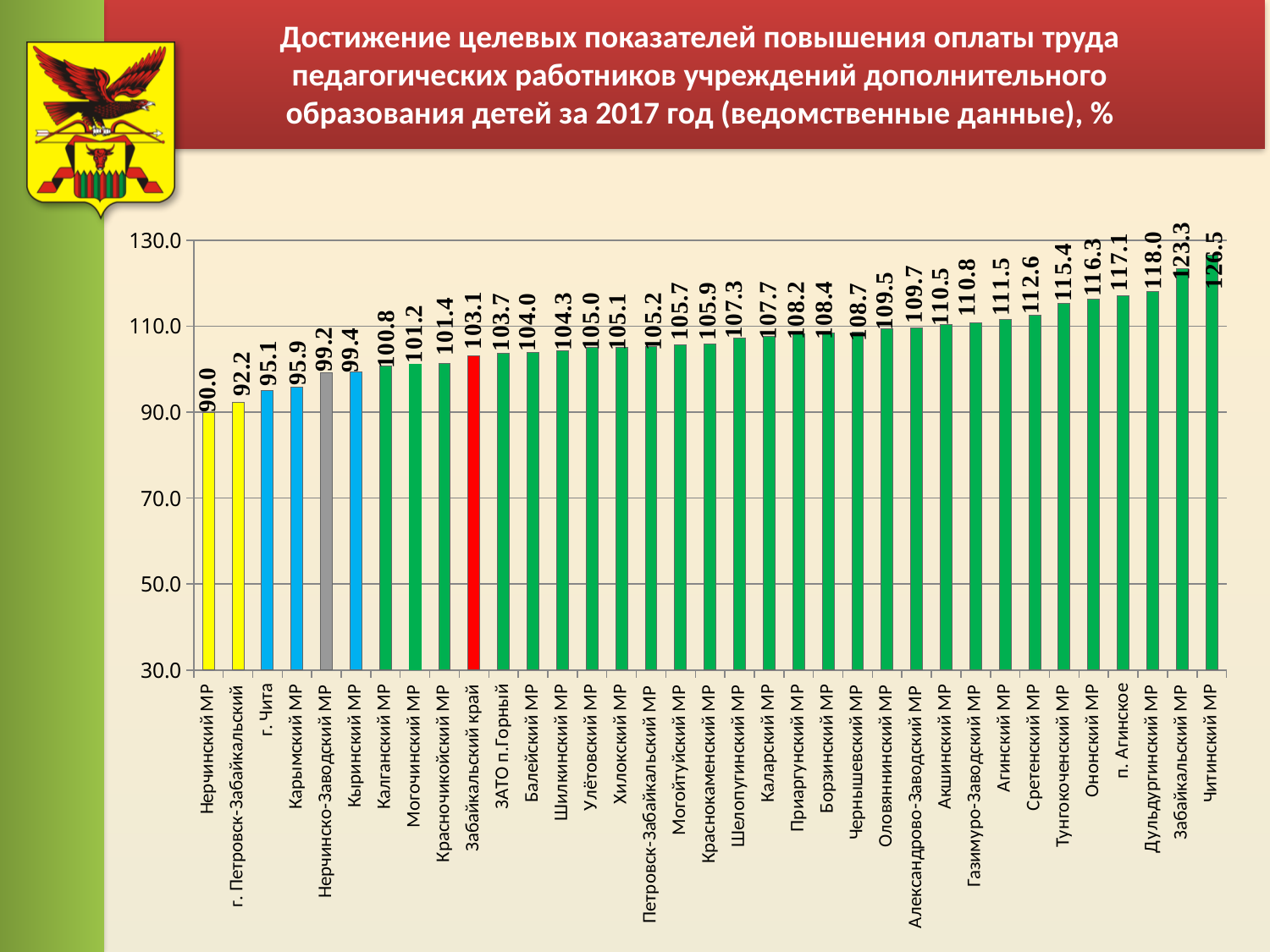
What is the value for Забайкальский край? 103.1 What is the difference between the values for Читинский МР and Нерчинский МР? 36.5 What is the value for г. Чита? 95.1 Is the value for Сретенский МР greater or less than 110? greater What is the value for Читинский МР? 126.5 What is the difference between the values for Забайкальский МР and Дульдургинский МР? 5.3 Which is larger, the value for Карымский МР or the value for Кыринский МР? Кыринский МР How many categories are shown on the chart? 35 What kind of chart is shown on the slide? bar chart Which category has the lowest value? Нерчинский МР Which category has the highest value? Читинский МР Do the values rise or fall from left to right along the x axis? rise